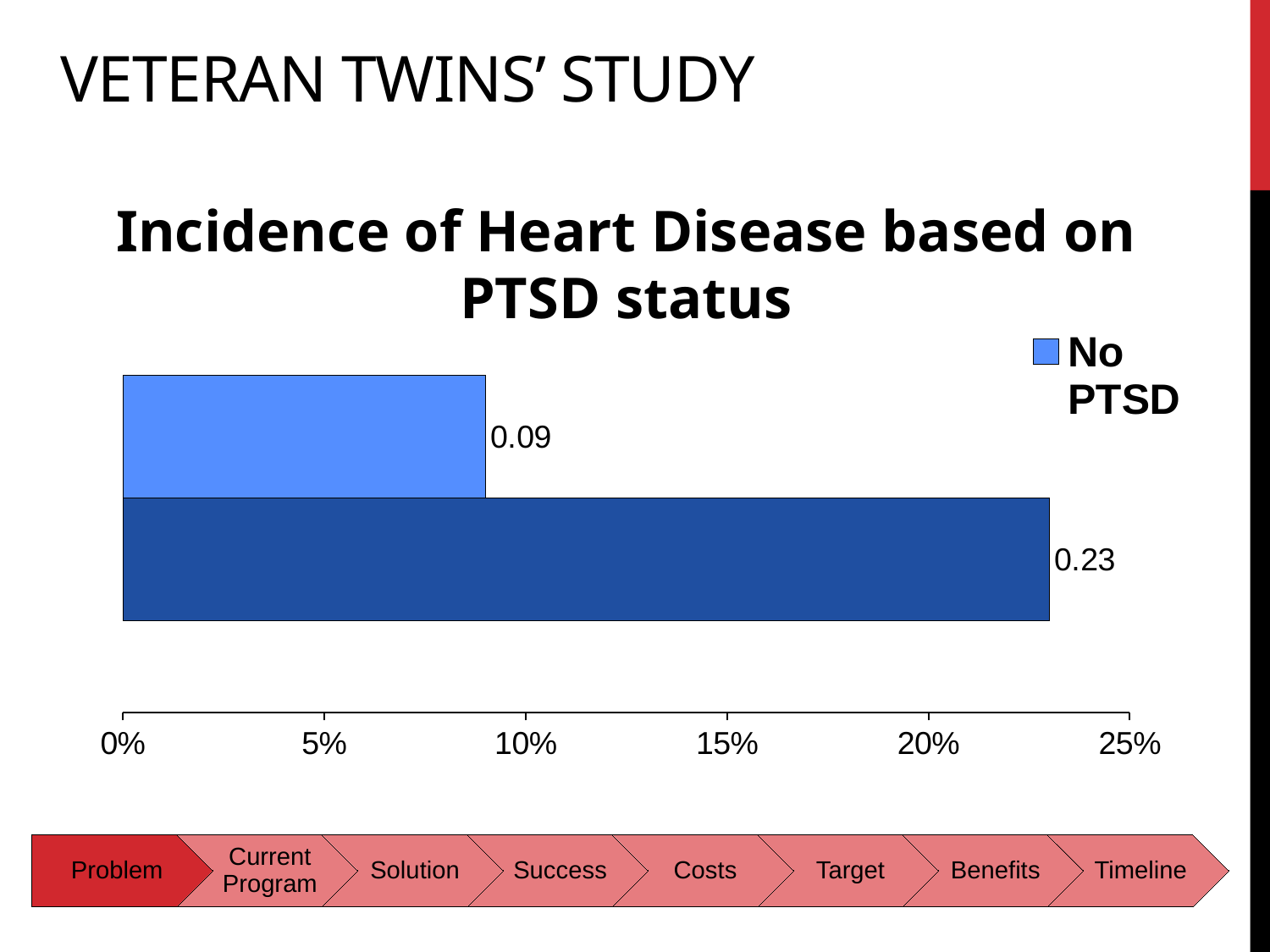
Is the value for the No PTSD bar greater or less than 10%? less What is the title of the chart? Incidence of Heart Disease based on PTSD status How many bars are plotted in the chart? 2 What is the difference between the dark blue bar's value (0.23) and the No PTSD bar's value (0.09)? 0.14 What kind of chart is shown on the slide? Bar chart Which bar has the highest value in the chart? The dark blue (lower) bar Which bar is longer, the No PTSD bar or the dark blue bar? The dark blue bar What is the value shown for the No PTSD bar? 0.09 What is the maximum value shown on the horizontal axis? 25% How many series does the chart legend list? 1 Is the value for the dark blue bar greater or less than 20%? greater What value is labelled on the dark blue (lower) bar? 0.23